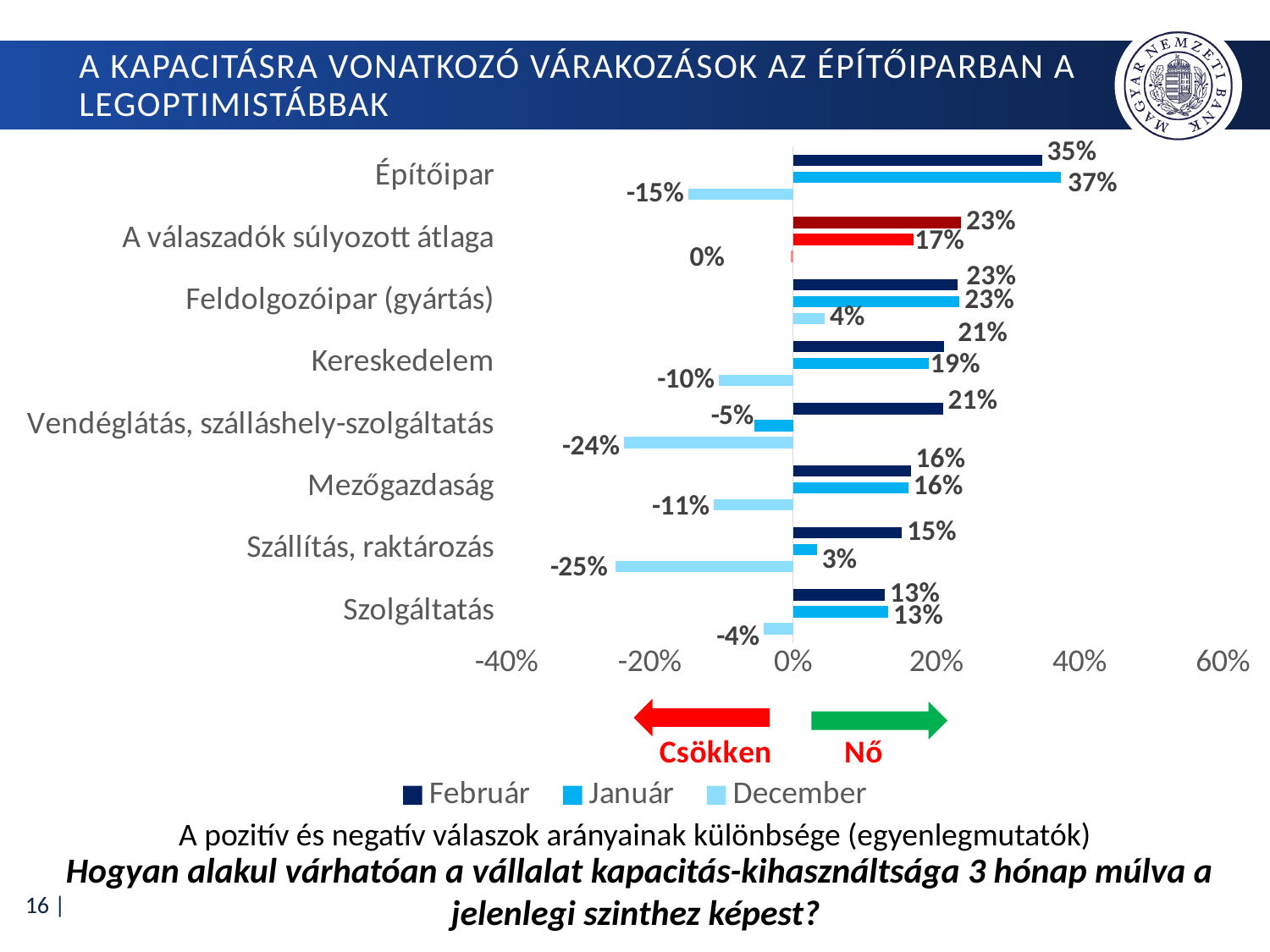
Which category has the lowest December value? Szállítás, raktározás What kind of chart is shown on the slide? Bar chart How many categories are shown on the chart? 8 What is the Február value for Építőipar? 35% Which is larger for Szállítás, raktározás: the Február value or the Január value? Február How many series does the legend list? 3 Which category has the highest Január value? Építőipar What is the December value for Szállítás, raktározás? -25% What is the Január value for Vendéglátás, szálláshely-szolgáltatás? -5% What is the December value for A válaszadók súlyozott átlaga? 0% What is the difference between the Január and December values for Építőipar? 52 percentage points Which category has the lowest Február value? Szolgáltatás